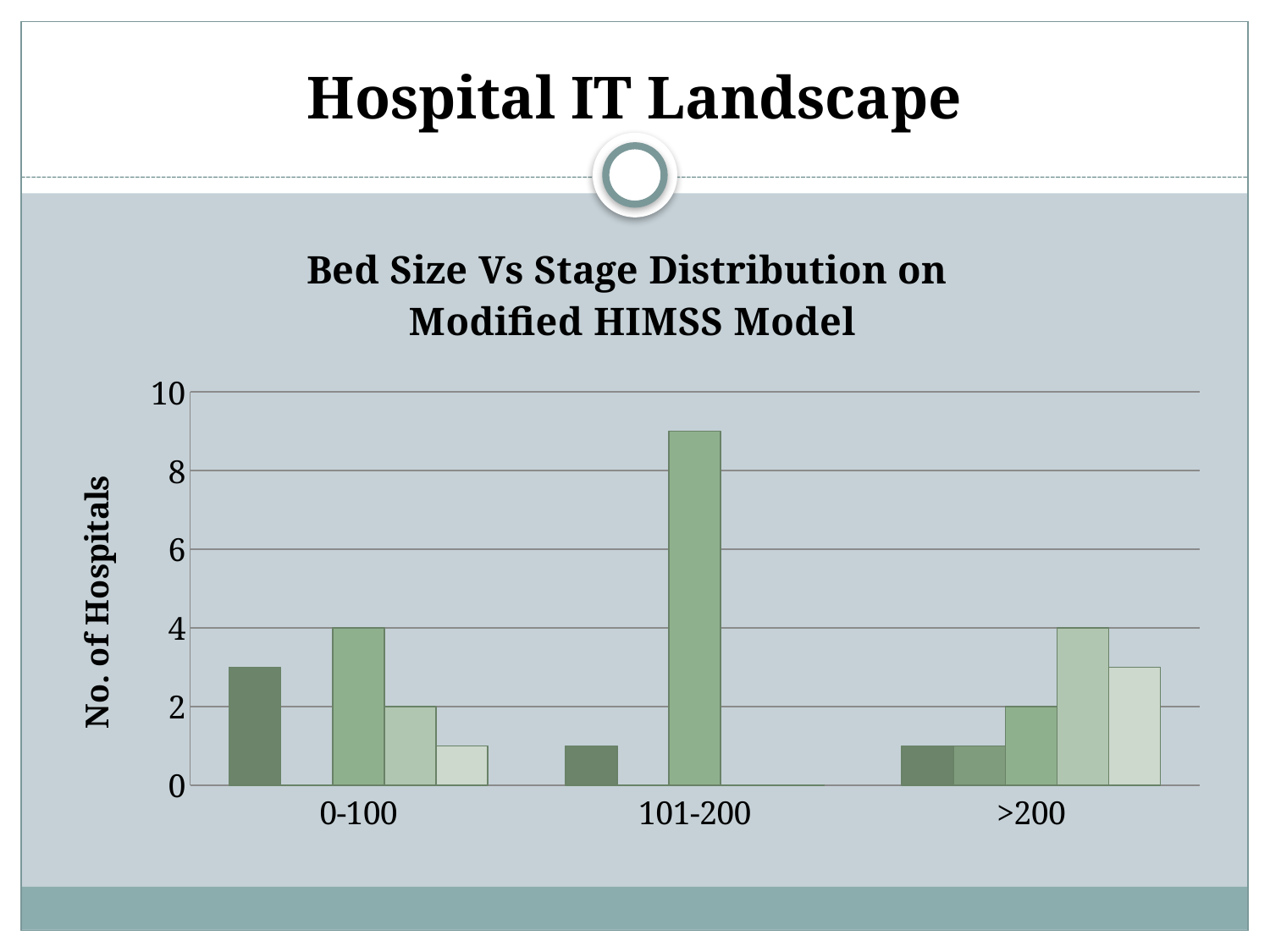
What is the value of the tallest bar in the 0-100 category? 4 What is the highest value shown on the vertical axis? 10 Is the tallest bar in the 101-200 category greater or less than 8? greater How many bars are visible in the >200 category? 5 What is the value of the tallest bar in the >200 category? 4 Which is taller: the tallest bar in the 0-100 category or the tallest bar in the 101-200 category? 101-200 What is the title of the chart? Bed Size Vs Stage Distribution on Modified HIMSS Model What is the value of the third bar from the left in the 0-100 category? 2 Which bed-size category contains the tallest bar in the chart? 101-200 What type of chart is shown on the slide? bar chart What is the label on the vertical axis of the chart? No. of Hospitals How many bed-size categories are shown on the x axis? 3